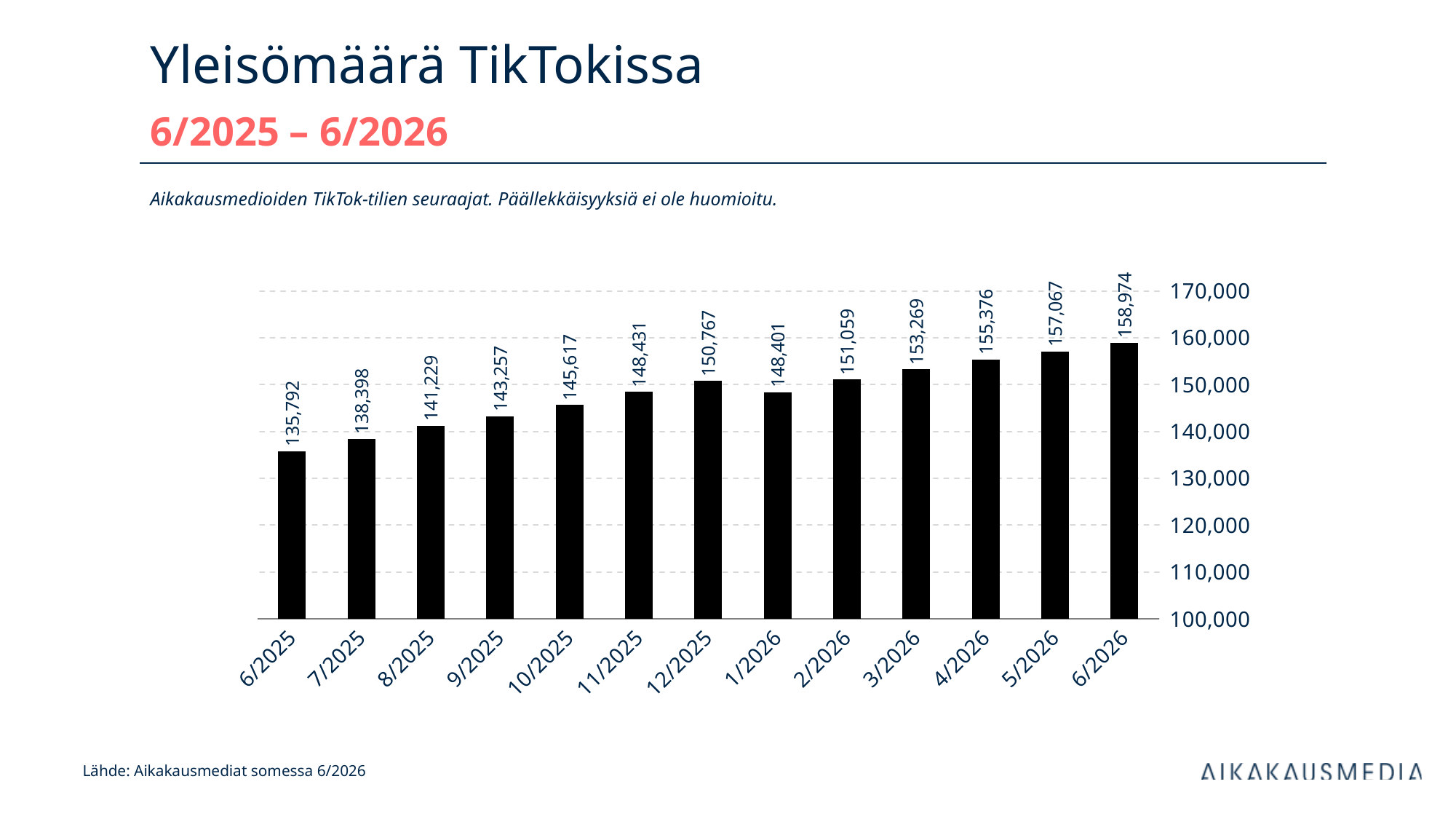
Do the values generally rise or fall from 6/2025 to 6/2026? Rise How many months are shown on the x axis? 13 What kind of chart is shown on the slide? Bar chart What is the difference between the values for 6/2026 and 6/2025? 23,182 What is the value for 1/2026? 148,401 Which month has the highest value? 6/2026 Which month has the lowest value? 6/2025 What is the title of the chart on the slide? Yleisömäärä TikTokissa Is the value for 3/2026 greater or less than 150,000? greater What is the value for 6/2025? 135,792 What is the value for 6/2026? 158,974 Which is larger, the value for 12/2025 or the value for 1/2026? 12/2025